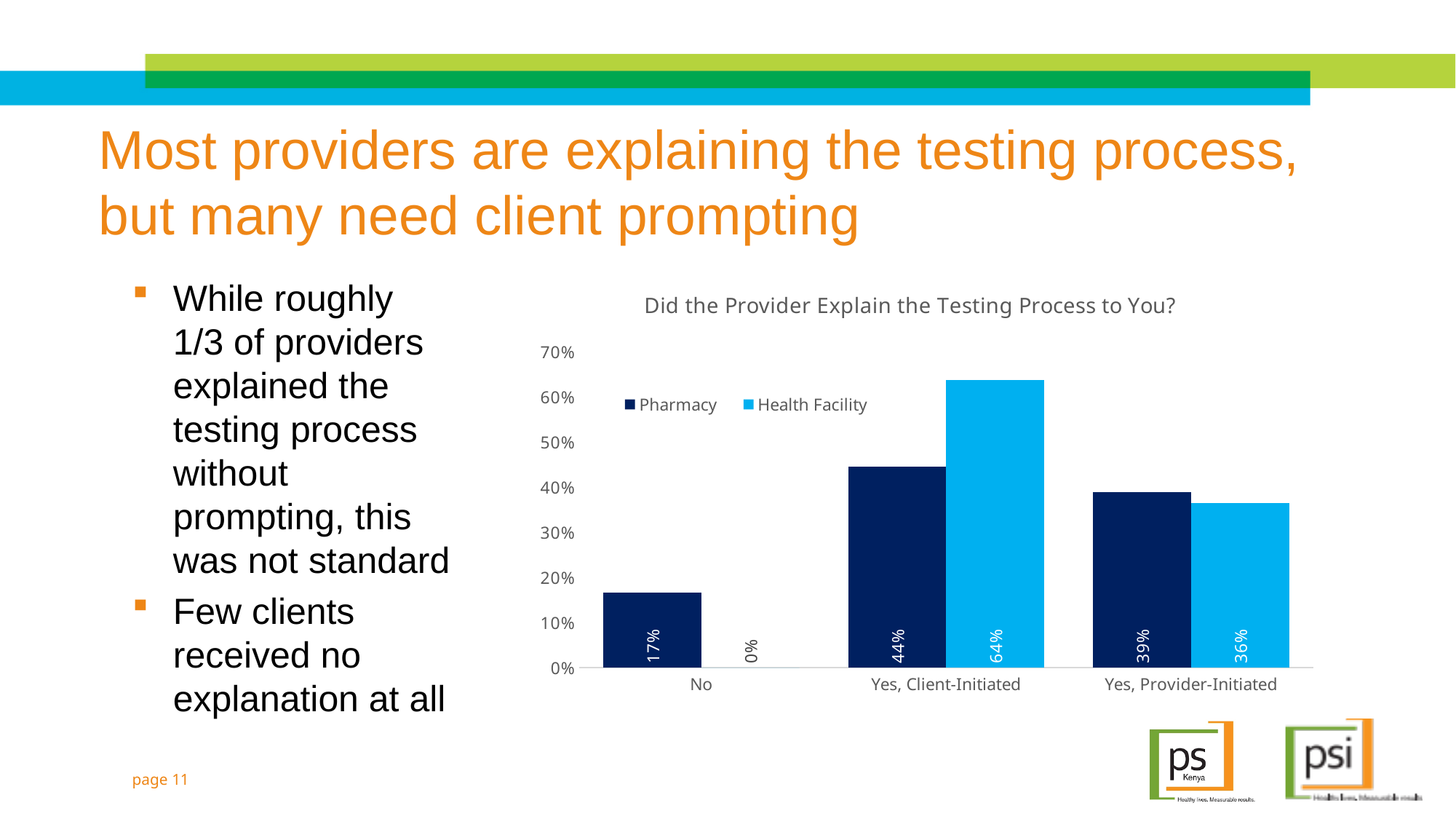
How many categories are shown on the x axis? 3 Which category has the highest Health Facility value? Yes, Client-Initiated How many series does the legend list? 2 What kind of chart is shown on the slide? Bar chart Which category has the lowest Pharmacy value? No What is the Pharmacy value for "Yes, Provider-Initiated"? 39% What is the Health Facility value for the "No" category? 0% What is the Health Facility value for "Yes, Client-Initiated"? 64% For "Yes, Provider-Initiated", which series has the larger value, Pharmacy or Health Facility? Pharmacy What is the Pharmacy value for the "No" category? 17% What is the difference between the Health Facility and Pharmacy values for "Yes, Client-Initiated"? 20% What is the title of the chart? Did the Provider Explain the Testing Process to You?